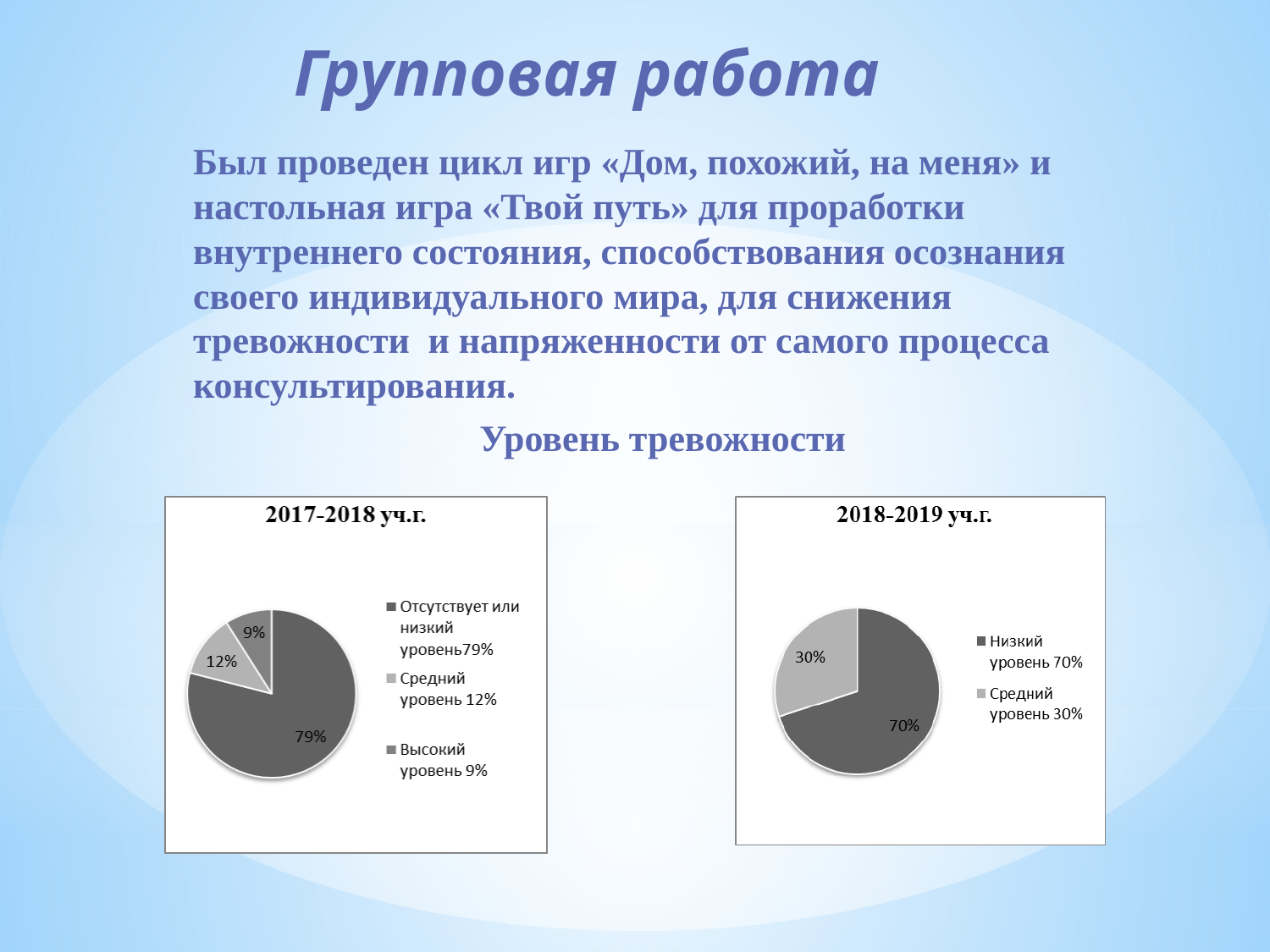
In the 2017-2018 уч.г. chart, which category has the smallest slice? Высокий уровень In the 2017-2018 уч.г. chart, how many slices does the pie have? 3 Which is larger: the 'Средний уровень' share in the 2017-2018 уч.г. chart or in the 2018-2019 уч.г. chart? 2018-2019 уч.г. In the 2017-2018 уч.г. chart, what share does the 'Высокий уровень' slice have? 9% In the 2018-2019 уч.г. chart, what share does the 'Средний уровень' slice have? 30% In the 2017-2018 уч.г. chart, what is the difference between the 'Средний уровень' and 'Высокий уровень' shares? 3% In the 2018-2019 уч.г. chart, what is the difference between the 'Низкий уровень' and 'Средний уровень' shares? 40% In the 2018-2019 уч.г. chart, how many categories does the legend list? 2 In the 2017-2018 уч.г. chart, which category has the largest slice? Отсутствует или низкий уровень In the 2018-2019 уч.г. chart, what share does the 'Низкий уровень' slice have? 70% What type of chart is the 2018-2019 уч.г. chart? Pie chart